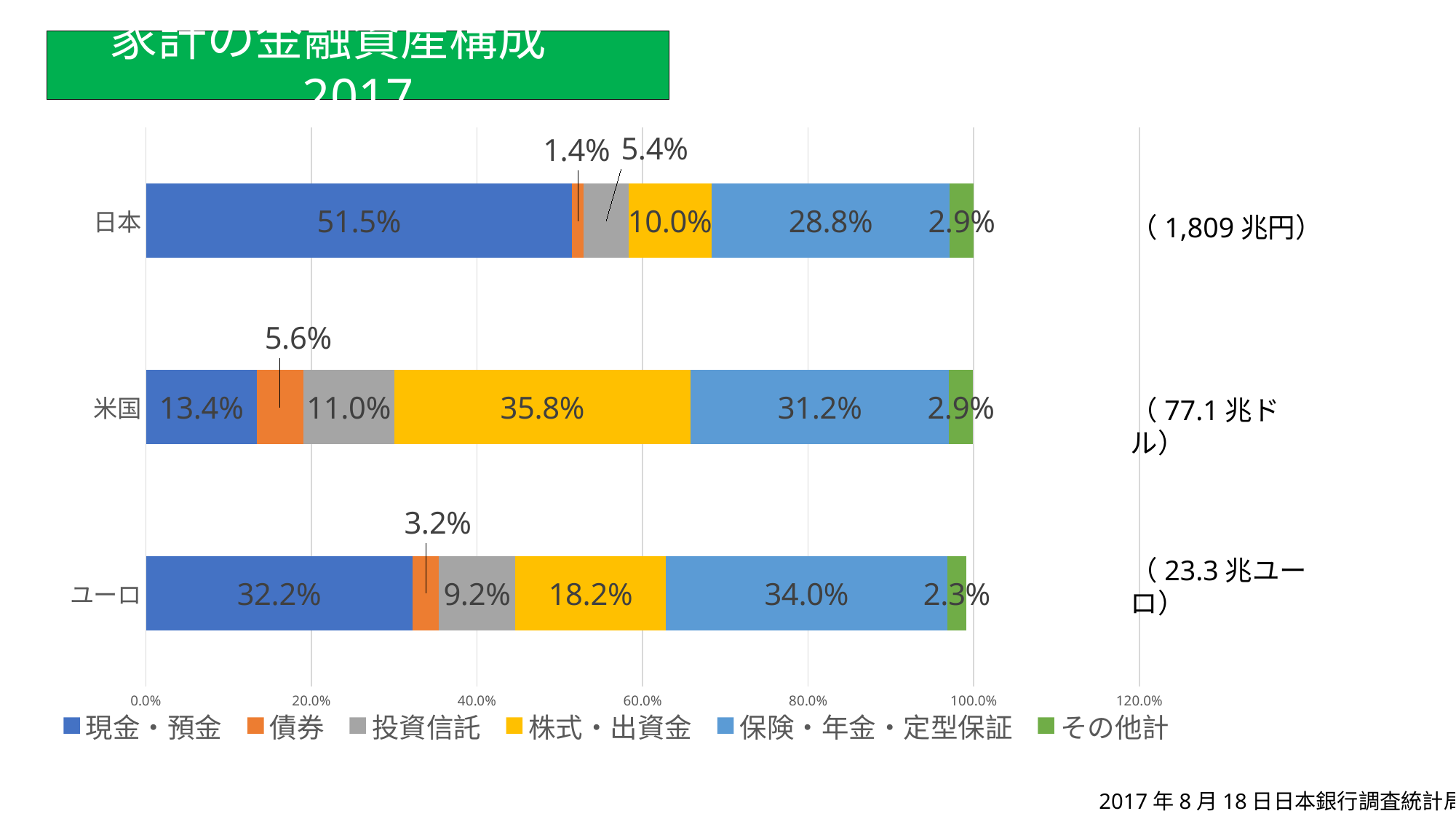
How many categories (regions) are plotted on the chart? 3 What is the value of 保険・年金・定型保証 for ユーロ? 34.0% Which is larger: the 投資信託 share of 米国 or of ユーロ? 米国 What is the difference between the 株式・出資金 share of 米国 and that of ユーロ? 17.6% What kind of chart is shown on the slide? stacked bar chart What is the value of 現金・預金 for 日本? 51.5% Which region has the highest share of 現金・預金? 日本 How many series does the legend list? 6 What is the value of 株式・出資金 for 米国? 35.8% What is the total financial asset amount shown next to the 日本 bar? 1,809 兆円 Which region has the lowest share of 株式・出資金? 日本 What is the value of 債券 for 日本? 1.4%